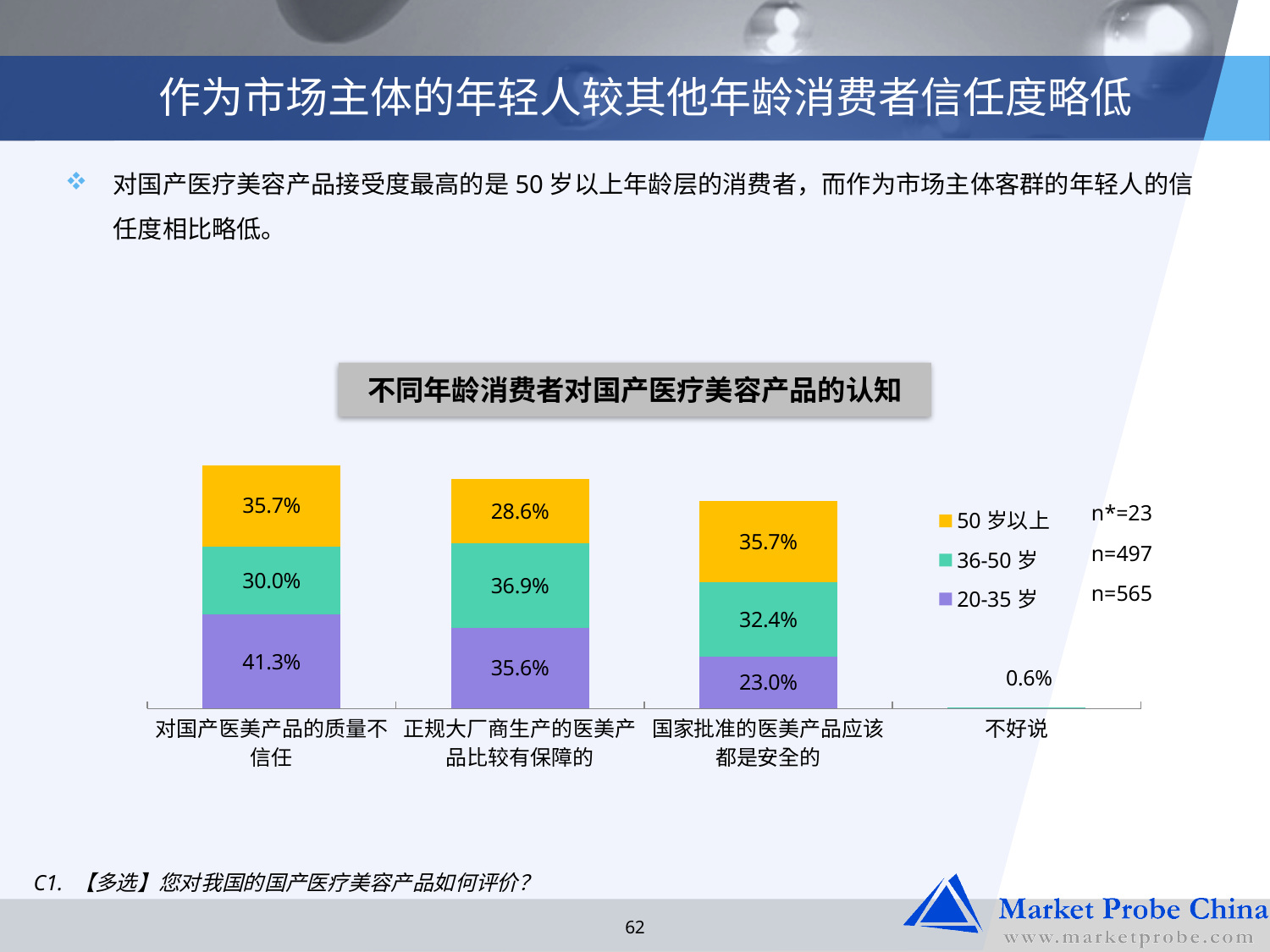
What is the total of the stacked bar for 国家批准的医美产品应该都是安全的? 91.1% Which is larger in the category 正规大厂商生产的医美产品比较有保障的: the value for 36-50 岁 or the value for 50 岁以上? 36-50 岁 How many categories are shown on the x axis? 4 What is the value shown for the category 不好说? 0.6% What kind of chart is shown on the slide? Stacked bar chart Which category has the lowest value for 20-35 岁 among the three labelled stacked bars? 国家批准的医美产品应该都是安全的 What is the title of the chart? 不同年龄消费者对国产医疗美容产品的认知 What is the value for 20-35 岁 in the category 对国产医美产品的质量不信任? 41.3% What is the value for 50 岁以上 in the category 正规大厂商生产的医美产品比较有保障的? 28.6% What is the value for 36-50 岁 in the category 国家批准的医美产品应该都是安全的? 32.4% How many series does the legend list? 3 What is the difference between the 20-35 岁 value and the 36-50 岁 value in the category 对国产医美产品的质量不信任? 11.3%